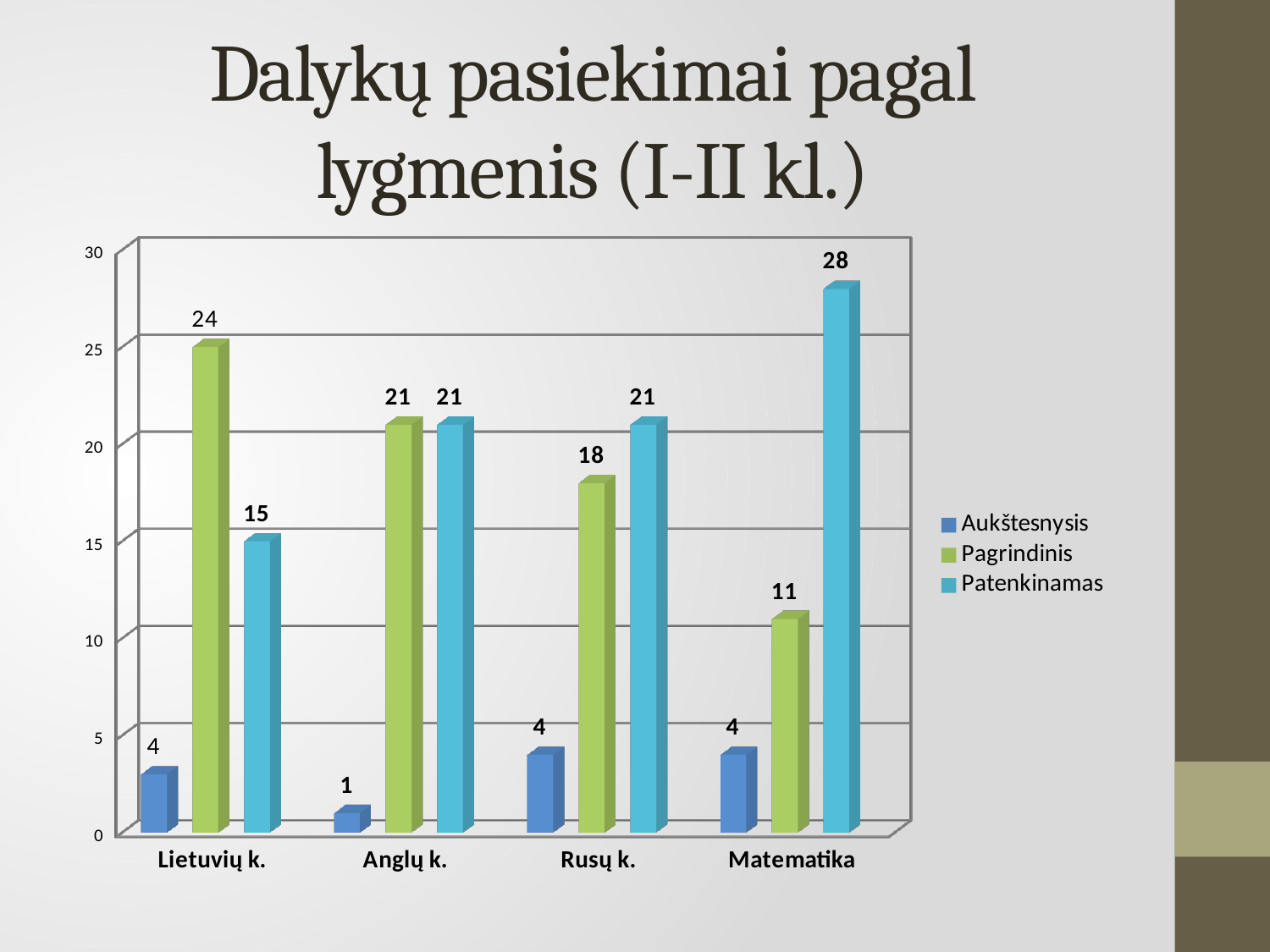
Which category has the lowest Aukštesnysis value? Anglų k. How many categories are shown on the x axis? 4 What is the title of the slide containing the chart? Dalykų pasiekimai pagal lygmenis (I-II kl.) Which category has the highest Patenkinamas value? Matematika What is the value for Pagrindinis in Lietuvių k.? 24 How many series does the legend list? 3 What is the value for Patenkinamas in Matematika? 28 What is the value for Pagrindinis in Rusų k.? 18 What is the difference between the Pagrindinis and Patenkinamas values in Lietuvių k.? 9 Which is larger in Matematika: Pagrindinis or Patenkinamas? Patenkinamas What is the value for Aukštesnysis in Anglų k.? 1 What kind of chart is shown on the slide? Bar chart